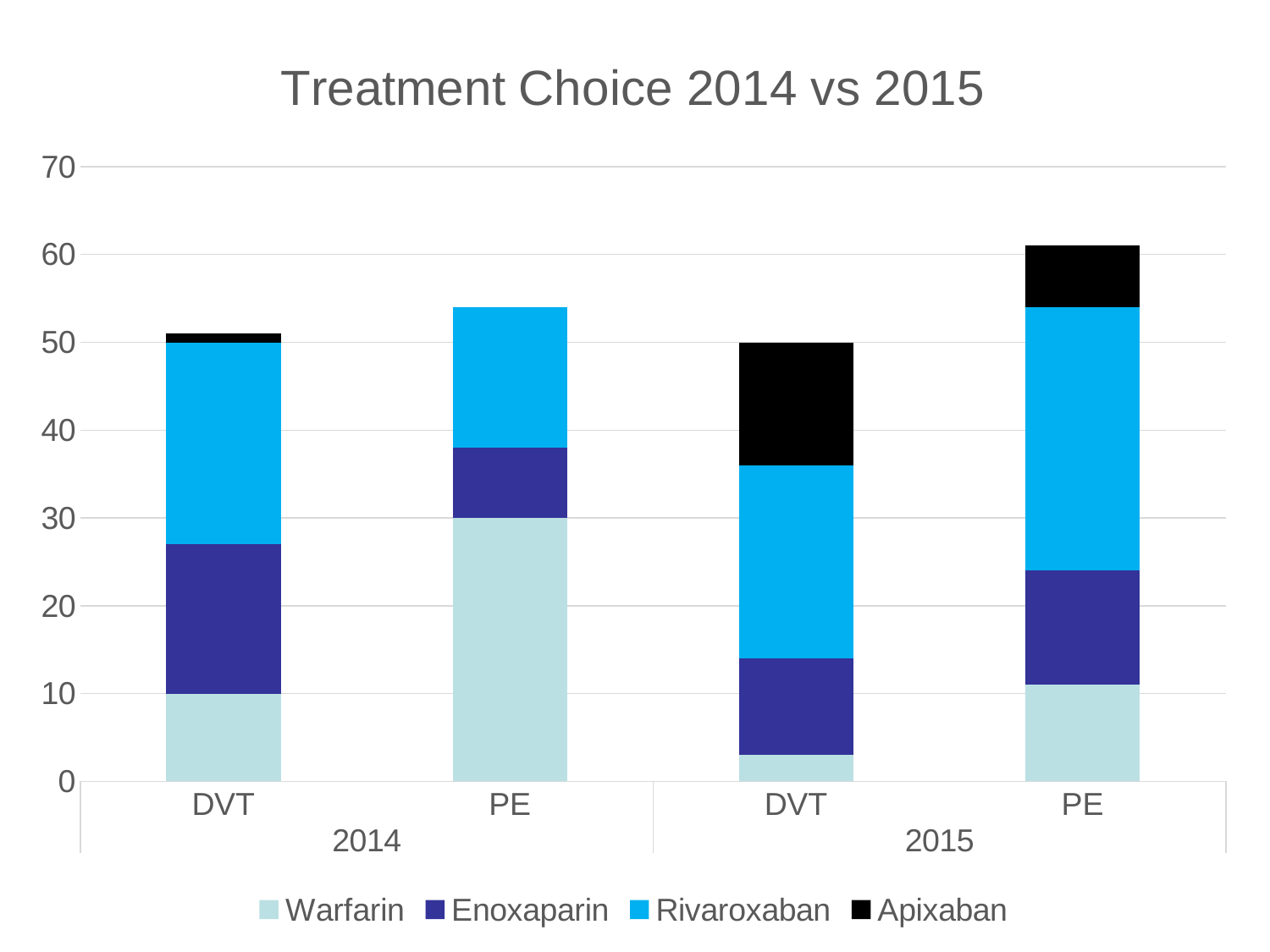
Which bar has the largest Warfarin segment? PE 2014 Which bar has the smallest Warfarin segment? DVT 2015 Which colour represents Apixaban in the legend? Black Which bar has the largest Apixaban segment? DVT 2015 How many bars are plotted in the chart? 4 Which is larger, the total for PE in 2014 or the total for PE in 2015? PE 2015 Is the total for PE in 2014 greater or less than 50? greater How many series does the legend list? 4 What is the title of the chart? Treatment Choice 2014 vs 2015 Is the Warfarin value for DVT in 2015 greater or less than 10? less Which bar has the highest total? PE 2015 What kind of chart is shown on the slide? Stacked bar chart